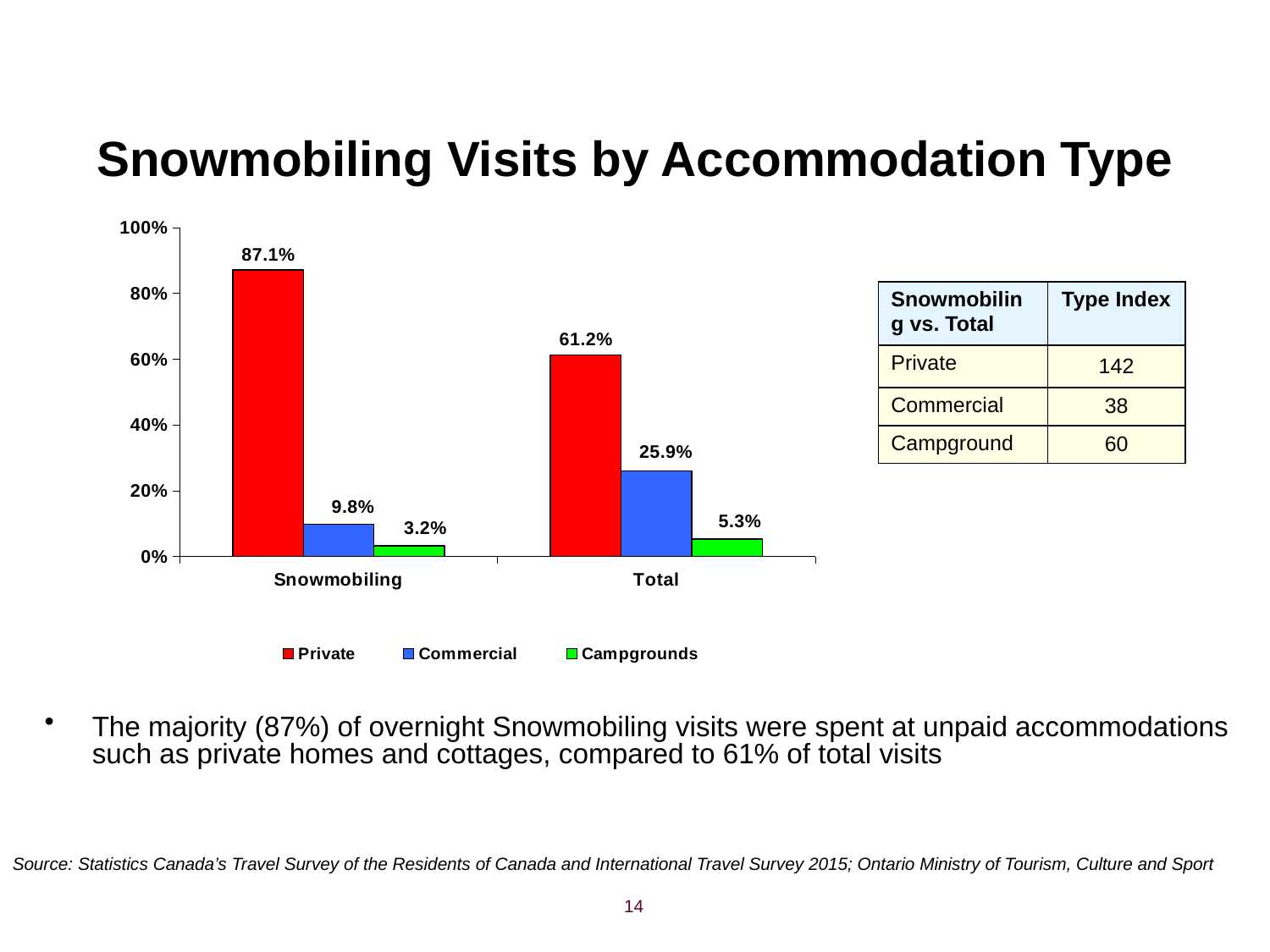
What is the value for Campgrounds in the Snowmobiling group? 3.2% What kind of chart is shown on the slide? bar chart How many series does the legend list? 3 Is the value for Private in the Total group greater or less than 80%? less What colour are the Commercial bars? blue What is the value for Commercial in the Total group? 25.9% How many categories are shown on the x axis? 2 Which is larger: Commercial for Snowmobiling or Commercial for Total? Commercial for Total Which series has the highest value in the Total group? Private Which series has the lowest value in the Snowmobiling group? Campgrounds What is the difference between the Private values for Snowmobiling and Total? 25.9% What is the value for Private in the Snowmobiling group? 87.1%